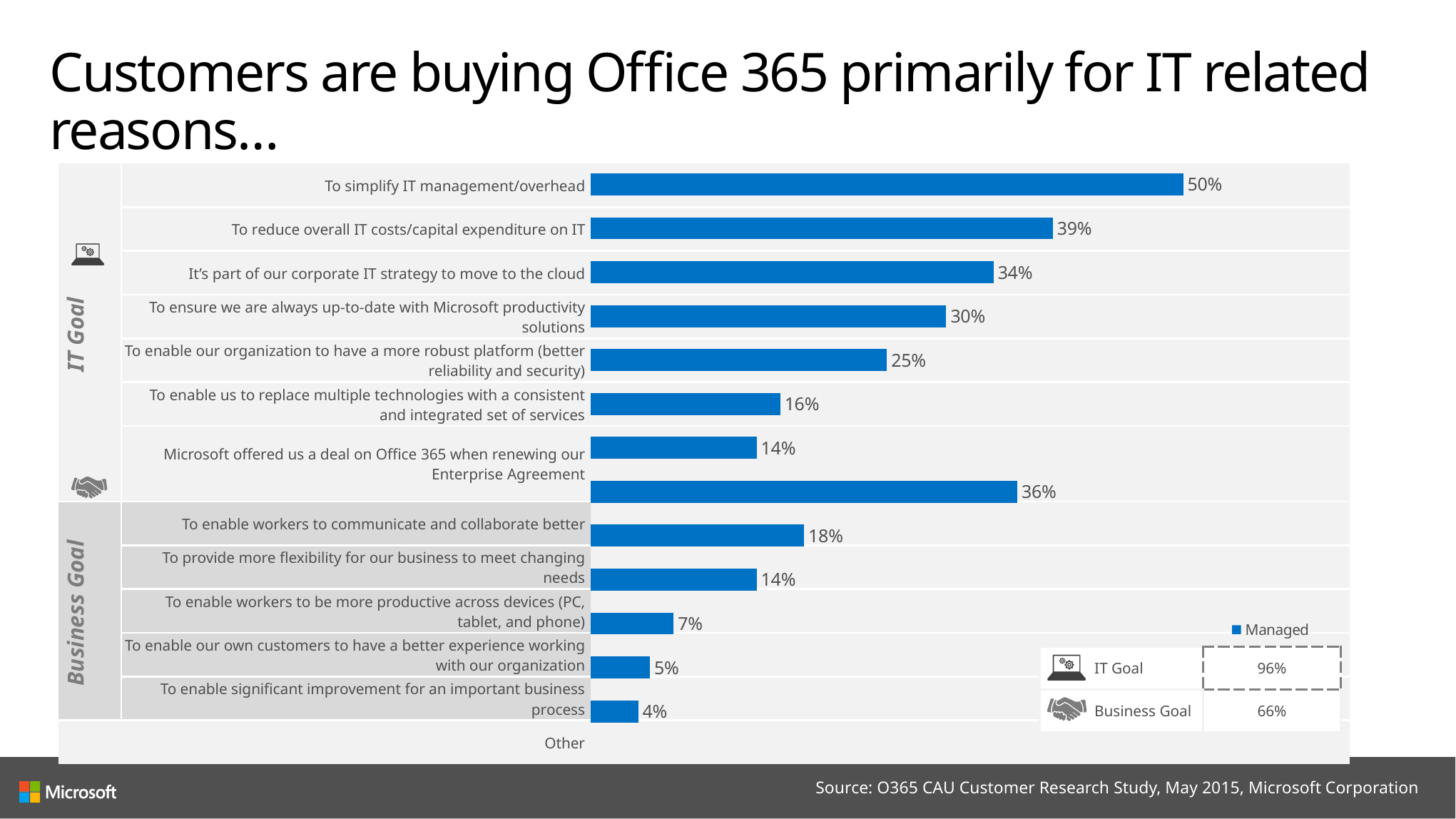
What is the value for "To simplify IT management/overhead"? 50% What is the value for "To enable our organization to have a more robust platform (better reliability and security)"? 25% What is the difference between "To simplify IT management/overhead" and "To reduce overall IT costs/capital expenditure on IT"? 11% What is the value for "To reduce overall IT costs/capital expenditure on IT"? 39% What kind of chart is shown on the slide? Bar chart What is the value for "It's part of our corporate IT strategy to move to the cloud"? 34% What is the name of the series shown in the legend? Managed What is the difference between "It's part of our corporate IT strategy to move to the cloud" and "To ensure we are always up-to-date with Microsoft productivity solutions"? 4% How many series does the legend list? 1 Which category has the highest value? To simplify IT management/overhead Which is larger: "To ensure we are always up-to-date with Microsoft productivity solutions" or "To enable us to replace multiple technologies with a consistent and integrated set of services"? To ensure we are always up-to-date with Microsoft productivity solutions What percentage is shown for IT Goal in the summary box at the bottom right of the chart? 96%